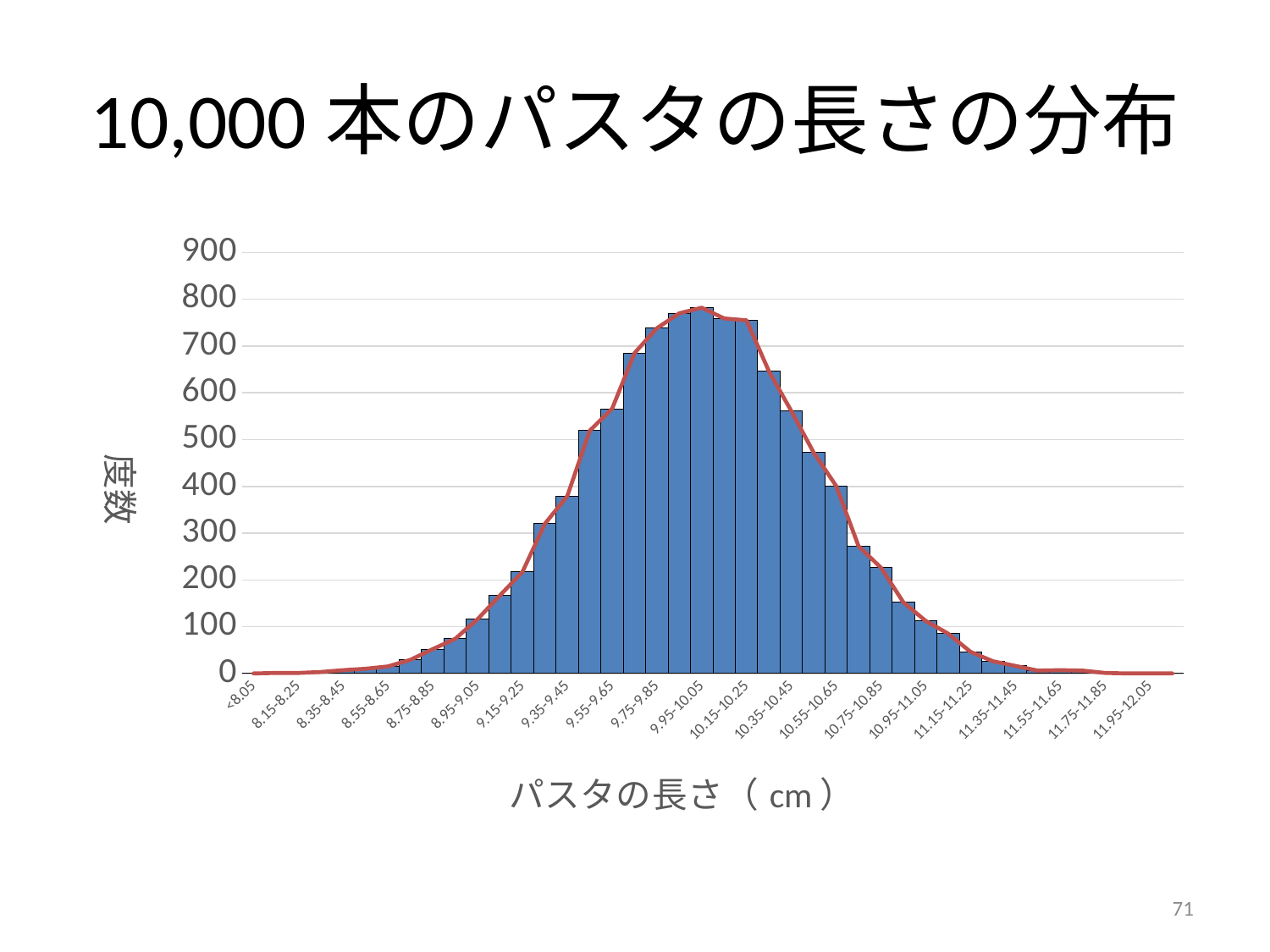
What is the title of the chart on the slide? 10,000 本のパスタの長さの分布 What kind of chart is shown on the slide? Bar chart (histogram) with a line overlay Which bin has the larger value, 9.75-9.85 or 10.35-10.45? 9.75-9.85 Is the value for the 10.75-10.85 bin greater or less than 300? less Is the value for the 9.95-10.05 bin greater or less than 700? greater Is the value for the 11.15-11.25 bin greater or less than 100? less What is the label of the vertical axis? 度数 Do the values rise or fall along the x axis from 10.15-10.25 to 11.95-12.05? fall